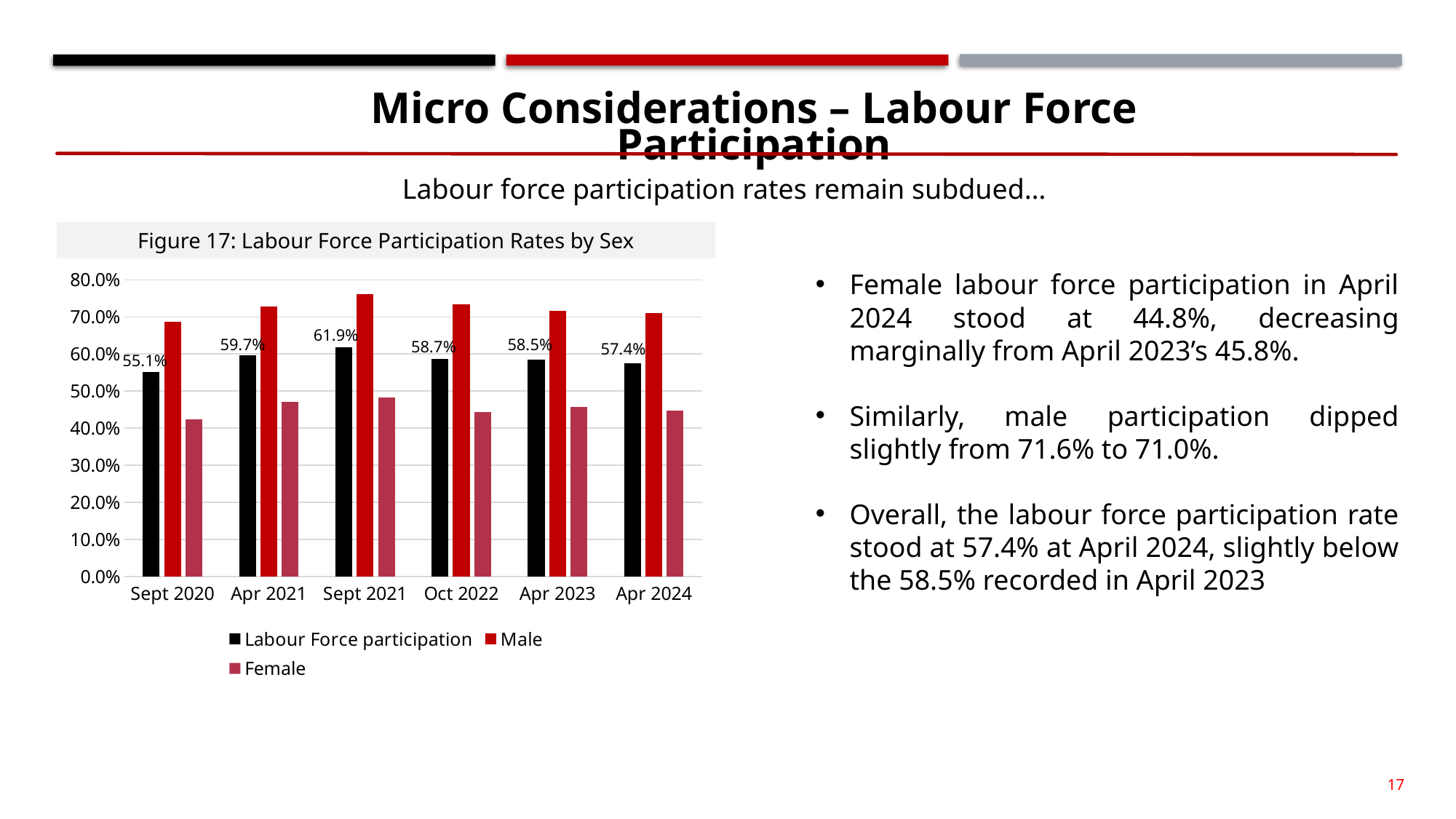
What is the difference between the Labour Force participation rates for Apr 2023 and Apr 2024? 1.1 percentage points What is the Labour Force participation rate shown for Apr 2024? 57.4% How many time periods are shown on the x axis of the chart? 6 What is the Labour Force participation rate shown for Sept 2020? 55.1% Is the Male value for Sept 2021 greater or less than 70.0%? greater In which period is the Labour Force participation rate lowest? Sept 2020 By how many percentage points does the Labour Force participation rate in Sept 2021 exceed that in Sept 2020? 6.8 percentage points In which period is the Labour Force participation rate highest? Sept 2021 How many series does the chart's legend list? 3 What type of chart is Figure 17? Bar chart Which period has the higher Labour Force participation rate, Apr 2021 or Oct 2022? Apr 2021 Is the Female value for Sept 2020 greater or less than 50.0%? less